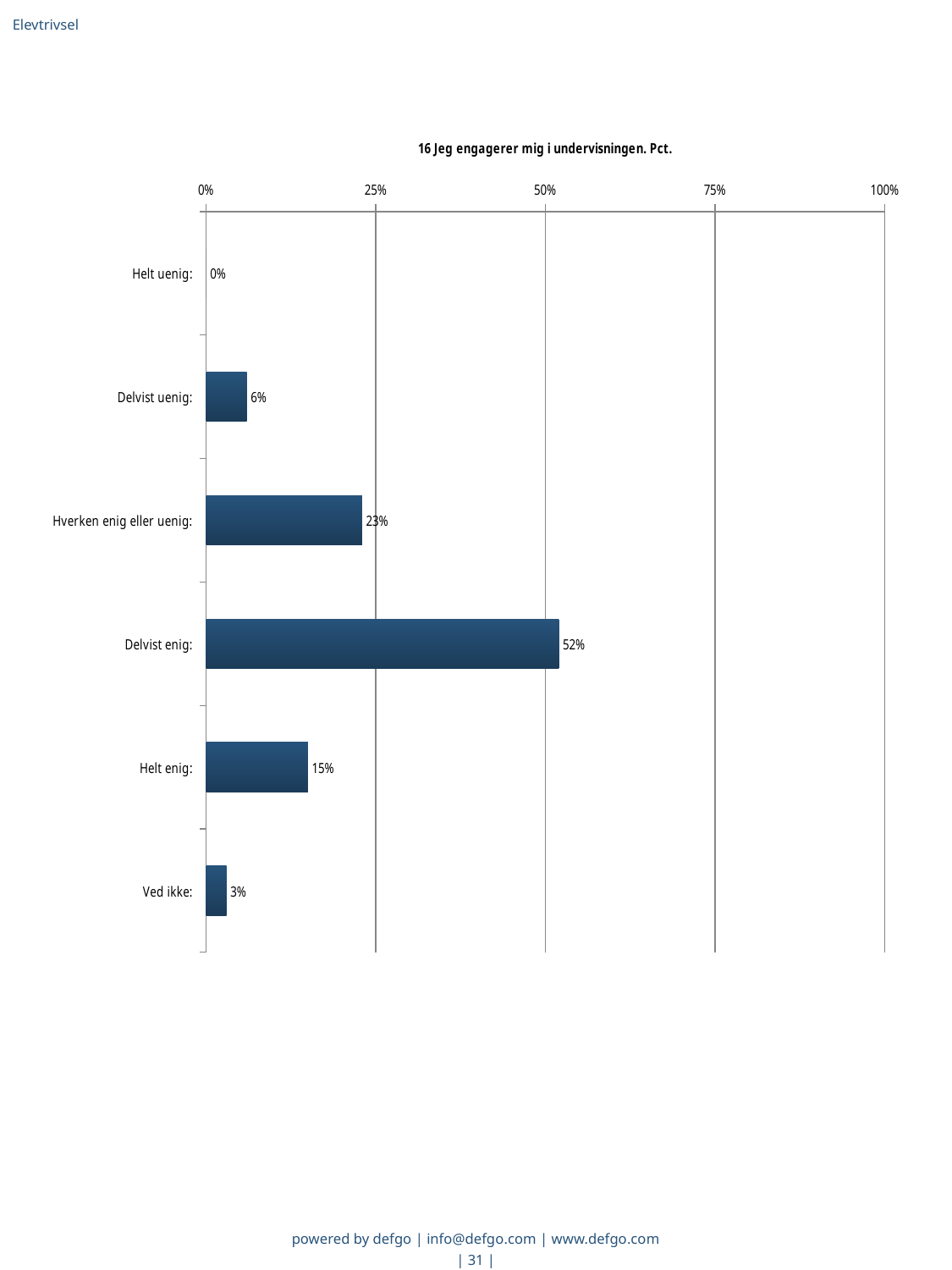
What is the value for "Hverken enig eller uenig"? 23% How many categories are shown in the chart? 6 What is the difference between the values for "Delvist enig" and "Helt enig"? 37% What is the value for "Helt uenig"? 0% What is the value for "Ved ikke"? 3% Which is larger, the value for "Helt enig" or the value for "Delvist uenig"? Helt enig Which category has the lowest value? Helt uenig What is the value for "Delvist enig"? 52% What is the title of the chart? 16 Jeg engagerer mig i undervisningen. Pct. Is the value for "Delvist enig" greater or less than 50%? greater Which category has the highest value? Delvist enig What kind of chart is shown on the slide? bar chart